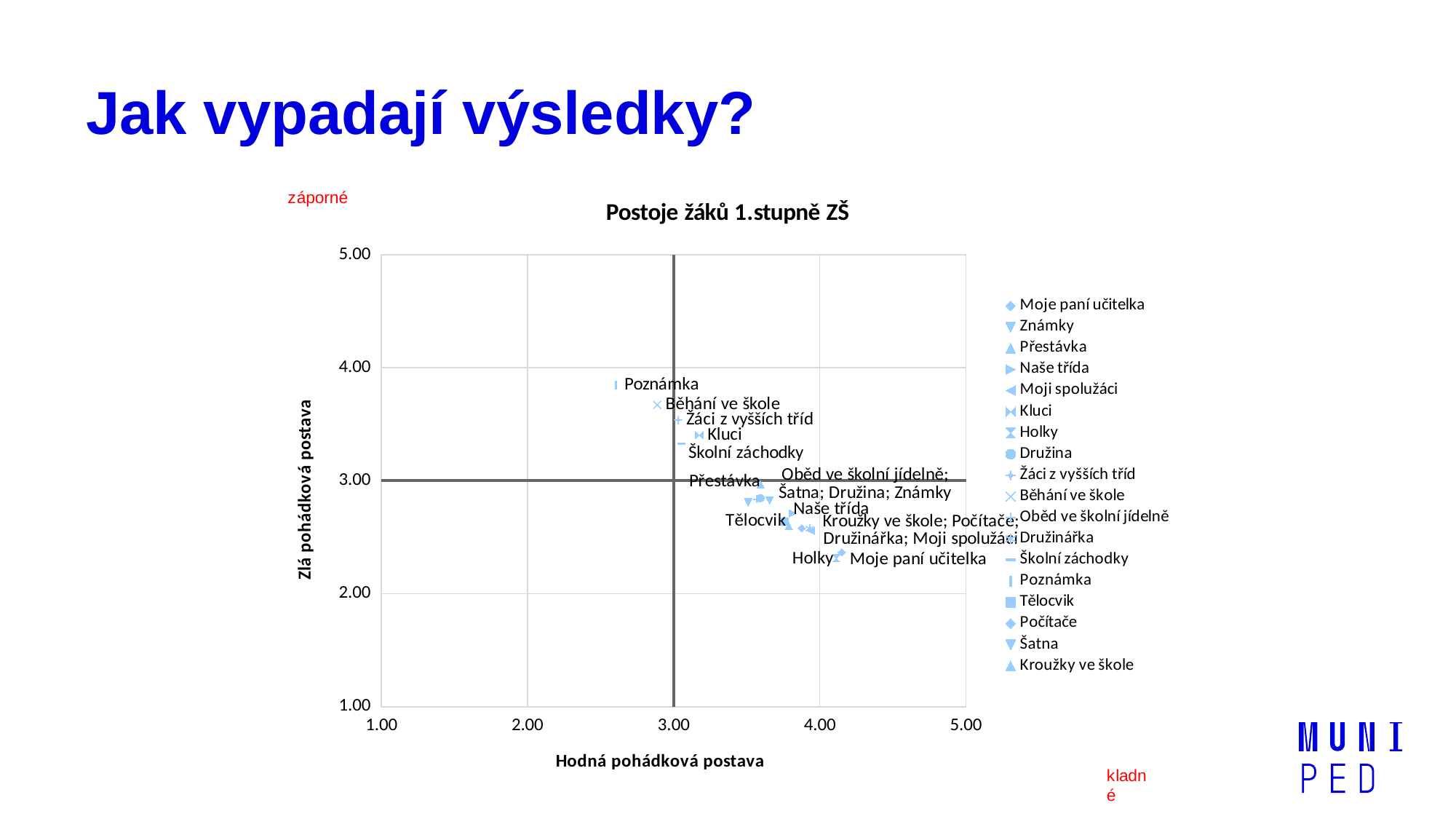
Is the vertical-axis value for Běhání ve škole greater or less than 3.00? greater Which series has the lowest value on the horizontal axis (Hodná pohádková postava)? Poznámka Is the horizontal-axis value for Poznámka greater or less than 3.00? less Is the horizontal-axis value for Tělocvik greater or less than 4.00? less How many series does the legend list? 18 Which has the higher vertical-axis value, Kluci or Tělocvik? Kluci What is the label of the horizontal axis? Hodná pohádková postava What kind of chart is shown on the slide? scatter chart What is the title of the chart? Postoje žáků 1.stupně ZŠ Which series has the highest value on the vertical axis (Zlá pohádková postava)? Poznámka